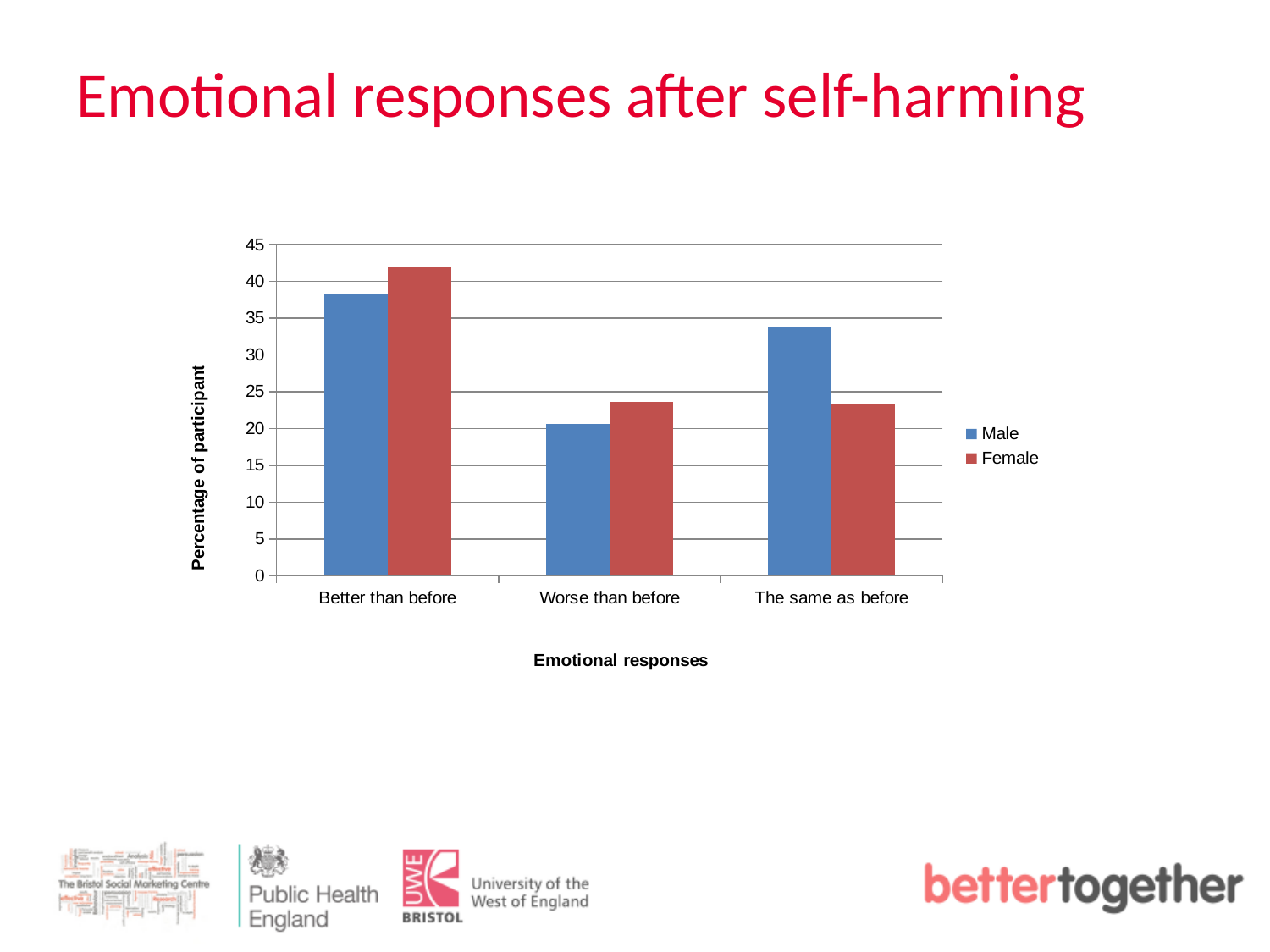
For 'Better than before', which is larger, Male or Female? Female Which category has the lowest value for Male? Worse than before What is the title of the vertical axis? Percentage of participant Is the Male value for 'Better than before' greater or less than 35? greater Is the Male value for 'Worse than before' greater or less than 25? less Is the Male value for 'The same as before' greater or less than 30? greater Which category has the highest value for Female? Better than before How many series does the legend list? 2 What kind of chart is shown on the slide? Bar chart How many emotional response categories are shown on the x axis? 3 For 'The same as before', which is larger, Male or Female? Male Which category has the highest value for Male? Better than before